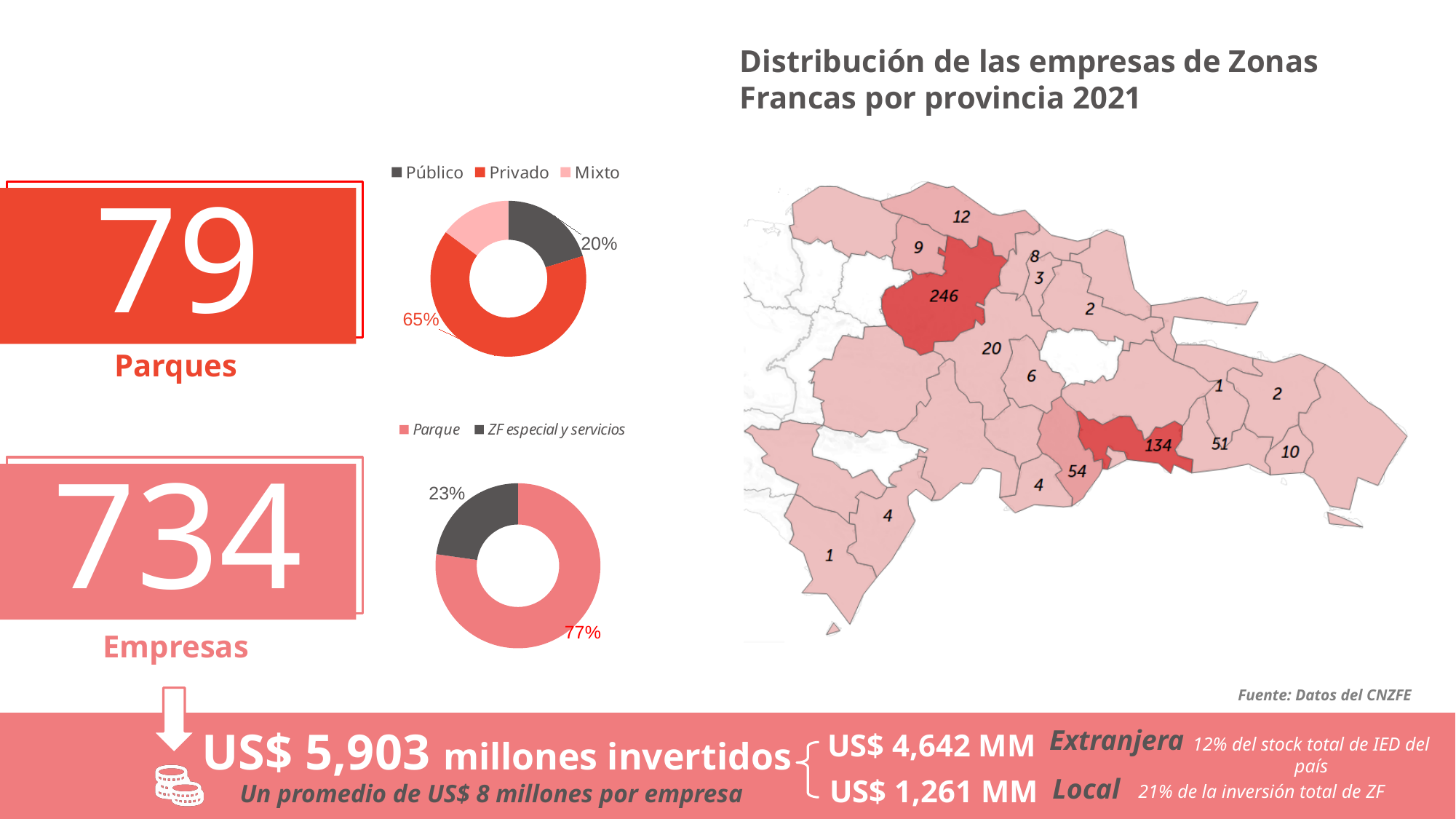
In the top donut chart, which category has the largest share? Privado In the top donut chart, what is the difference in percentage points between Privado and Público? 45 percentage points In the top donut chart (Público / Privado / Mixto), what share is labelled for Privado? 65% In the bottom donut chart, what share is labelled for Parque? 77% In the bottom donut chart, what is the difference in percentage points between Parque and ZF especial y servicios? 54 percentage points How many categories does the legend of the top donut chart list? 3 On the map 'Distribución de las empresas de Zonas Francas por provincia 2021', what is the highest number of companies shown for a single province? 246 How many categories does the legend of the bottom donut chart list? 2 What type of chart is used to show the Parque vs ZF especial y servicios split? Donut (pie) chart In the top donut chart, which is larger, Privado or Público? Privado In the bottom donut chart, what share is labelled for ZF especial y servicios? 23%